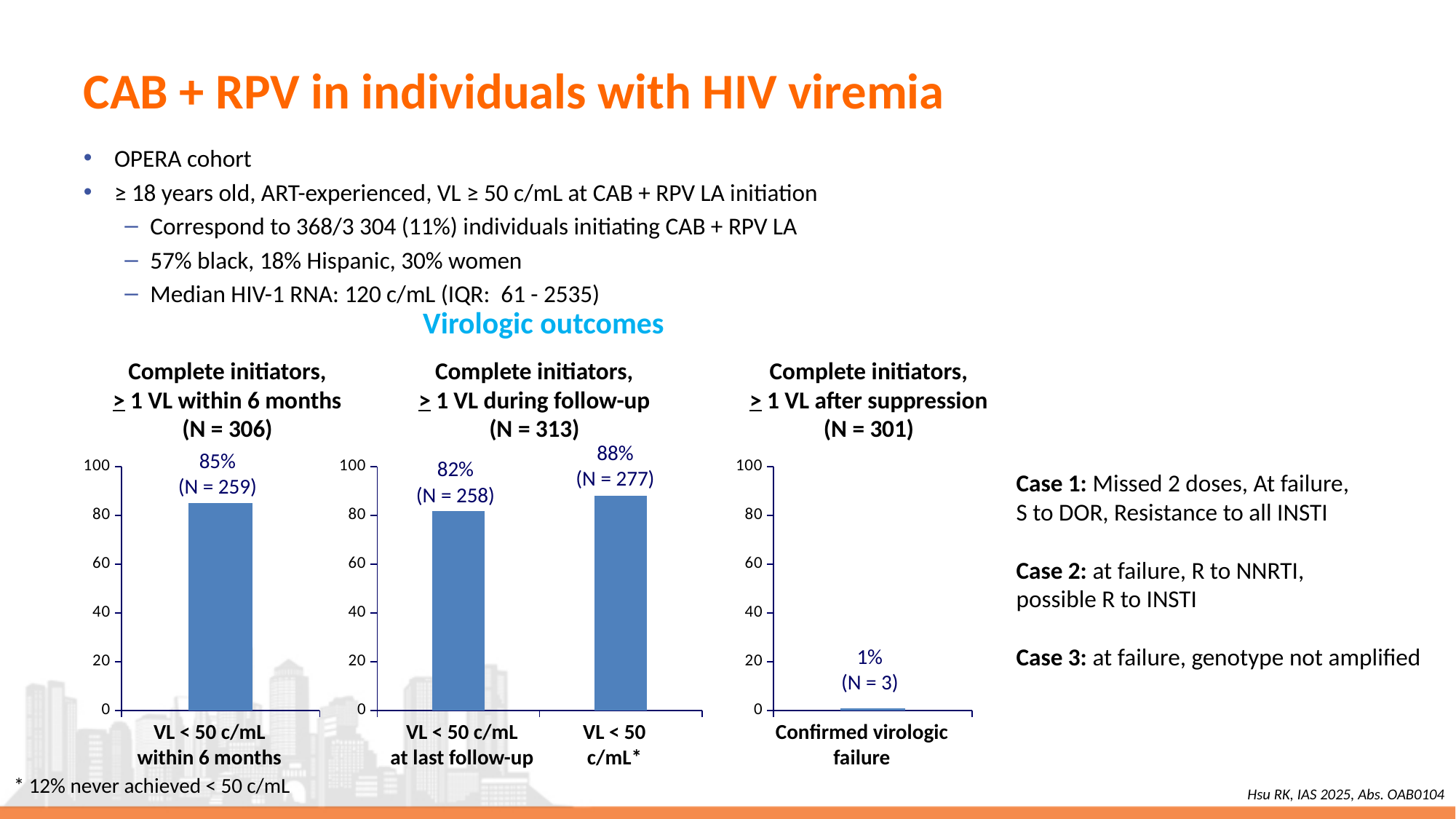
In the middle chart (Complete initiators, ≥ 1 VL during follow-up), which bar is higher: VL < 50 c/mL at last follow-up or VL < 50 c/mL*? VL < 50 c/mL* In the middle chart (Complete initiators, ≥ 1 VL during follow-up, N = 313), what percentage had VL < 50 c/mL at last follow-up? 82% In the middle chart (Complete initiators, ≥ 1 VL during follow-up), what percentage had VL < 50 c/mL*? 88% In the left chart (Complete initiators, ≥ 1 VL within 6 months), how many individuals (N) achieved VL < 50 c/mL within 6 months? N = 259 In the left chart (Complete initiators, ≥ 1 VL within 6 months), is the value for VL < 50 c/mL within 6 months greater or less than 80? greater In the right chart (Complete initiators, ≥ 1 VL after suppression, N = 301), what percentage had confirmed virologic failure? 1% In the left chart (Complete initiators, ≥ 1 VL within 6 months, N = 306), what percentage achieved VL < 50 c/mL within 6 months? 85% What type of chart is used for the Virologic outcomes on this slide? Bar chart What is the N for the middle chart (Complete initiators, ≥ 1 VL during follow-up)? N = 313 In the middle chart (Complete initiators, ≥ 1 VL during follow-up), what is the difference in percentage points between VL < 50 c/mL* and VL < 50 c/mL at last follow-up? 6 percentage points How many bars does the middle chart (Complete initiators, ≥ 1 VL during follow-up) show? 2 In the right chart (Complete initiators, ≥ 1 VL after suppression), how many individuals (N) had confirmed virologic failure? N = 3